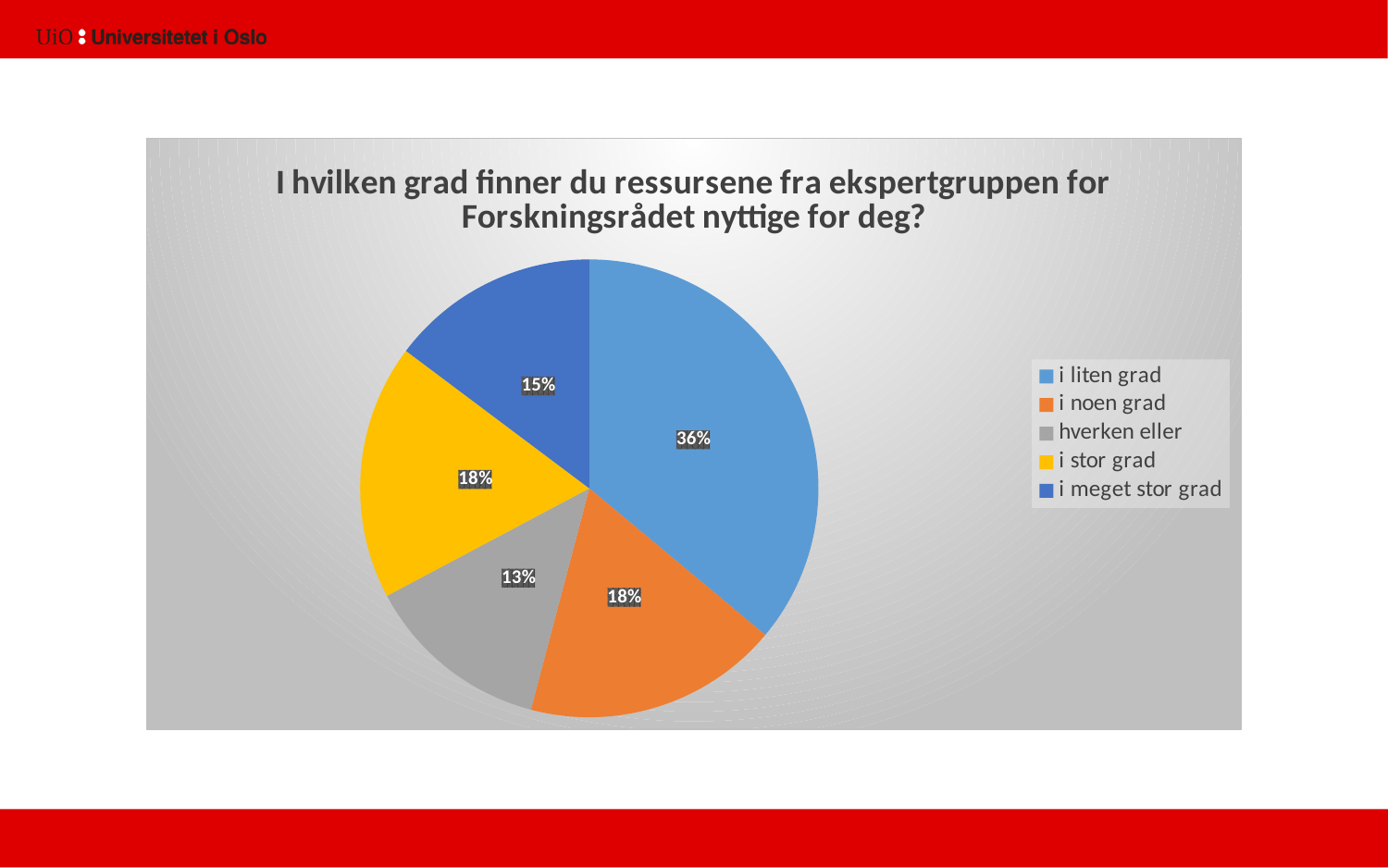
What kind of chart is shown on the slide? pie chart What is the difference in percentage points between "i liten grad" and "i meget stor grad"? 21 What share of the pie is labelled "i stor grad"? 18% Which category has the smallest slice of the pie? hverken eller What share of the pie is labelled "hverken eller"? 13% What is the title of the chart? I hvilken grad finner du ressursene fra ekspertgruppen for Forskningsrådet nyttige for deg? Which is larger, the slice for "i noen grad" or the slice for "hverken eller"? i noen grad What share of the pie is labelled "i meget stor grad"? 15% What colour is the slice for "i stor grad"? yellow Which category has the largest slice of the pie? i liten grad How many categories does the legend list? 5